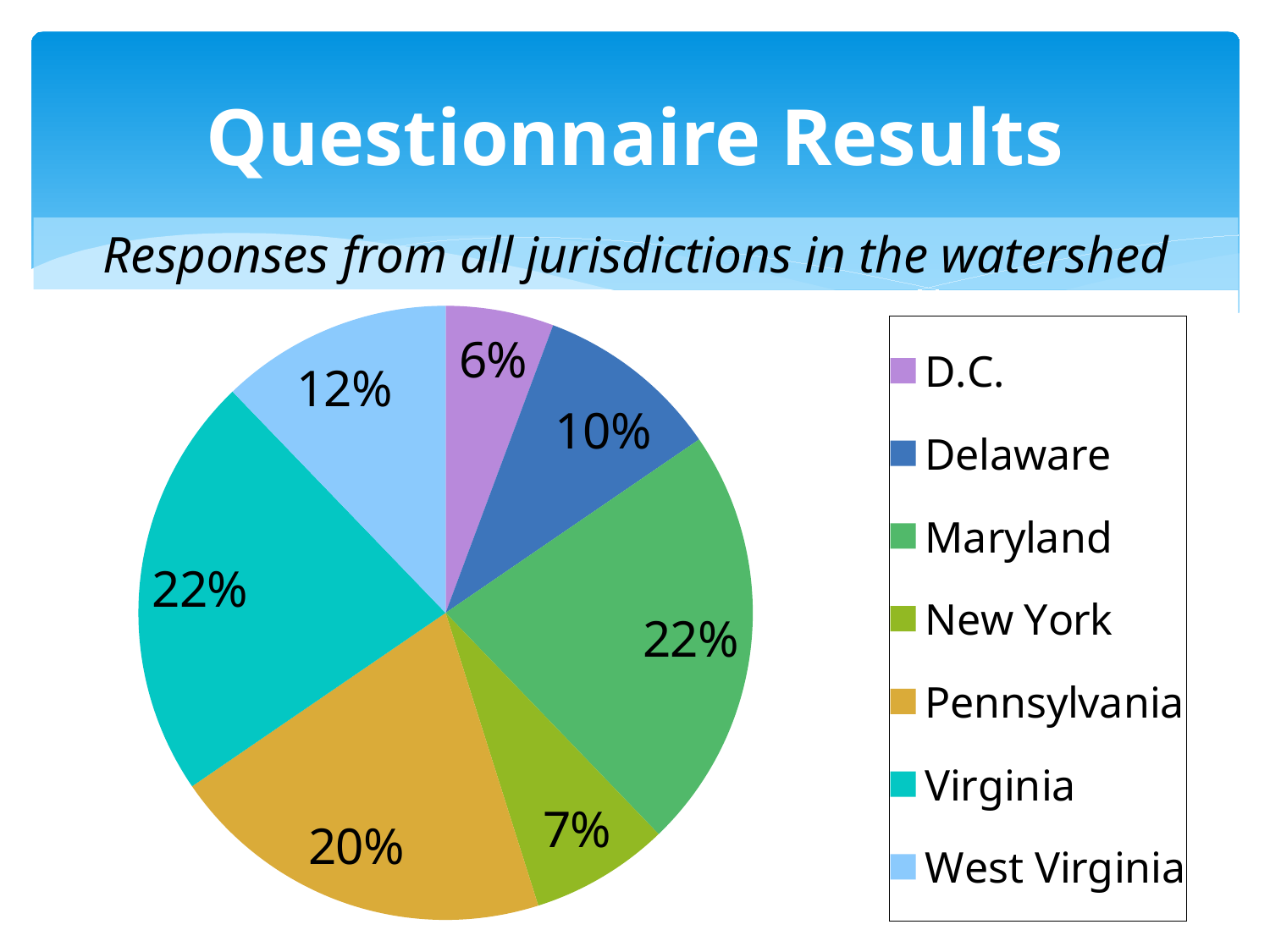
What share of responses came from West Virginia? 12% What share of responses came from Maryland? 22% How many jurisdictions are shown in the pie chart? 7 What is the subtitle shown above the pie chart? Responses from all jurisdictions in the watershed What kind of chart is shown on the slide? pie chart Which jurisdiction has the smallest share of responses? D.C. What share of responses came from New York? 7% What is the difference in percentage points between Virginia's share and Pennsylvania's share? 2 Which has the larger share of responses, Delaware or West Virginia? West Virginia What is the difference in percentage points between West Virginia's share and D.C.'s share? 6